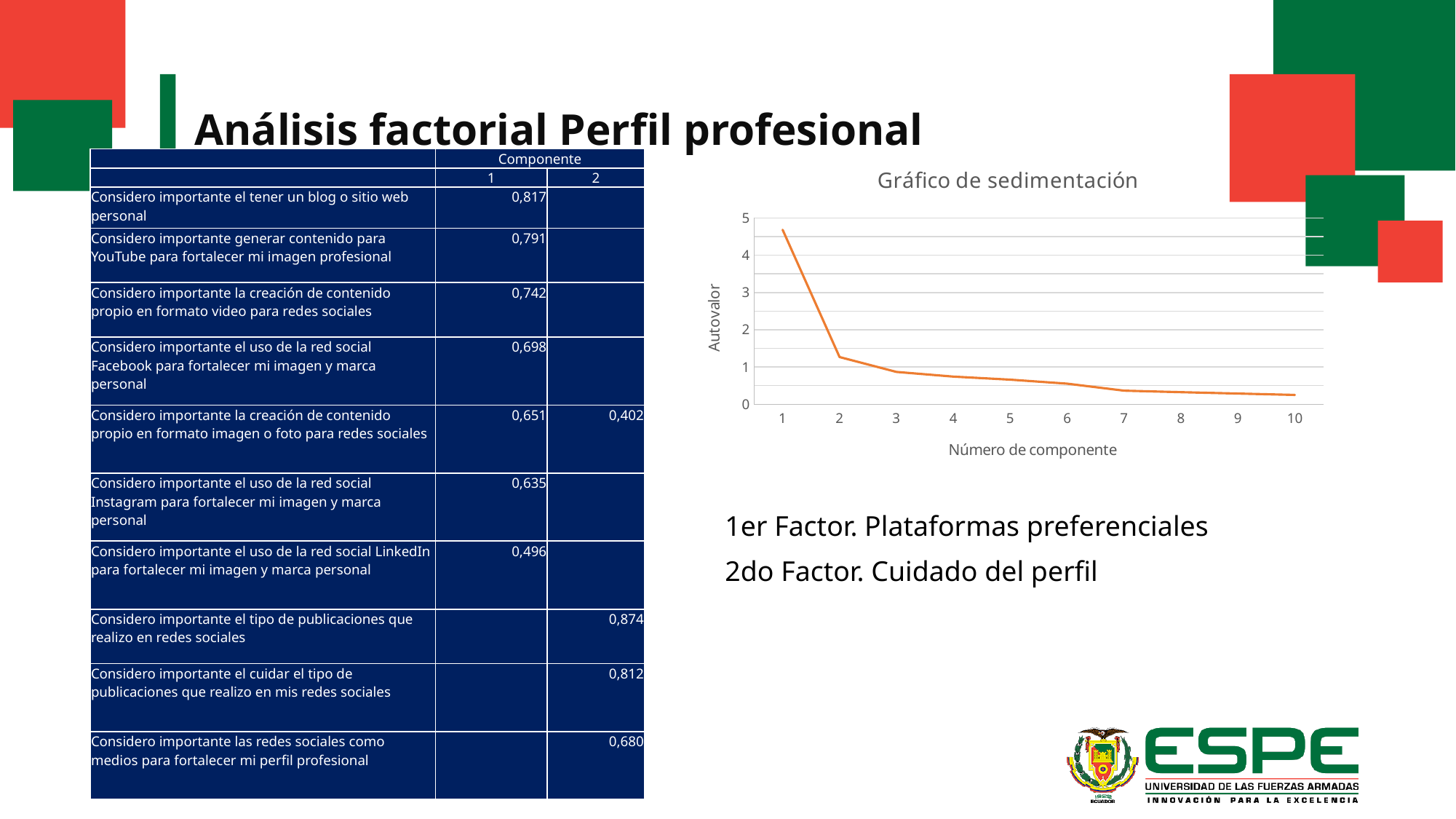
Do the values in the chart rise or fall as the component number increases? fall Which has a larger autovalor in the chart, component 1 or component 2? component 1 Is the autovalor for component 1 greater or less than 4? greater Is the autovalor for component 2 greater or less than 2? less Which component number has the highest autovalor in the chart? 1 What kind of chart is the 'Gráfico de sedimentación'? line chart What is the title of the chart on the slide? Gráfico de sedimentación Is the autovalor for component 7 greater or less than 1? less What is the label of the vertical axis of the chart? Autovalor How many components are plotted along the x axis of the chart? 10